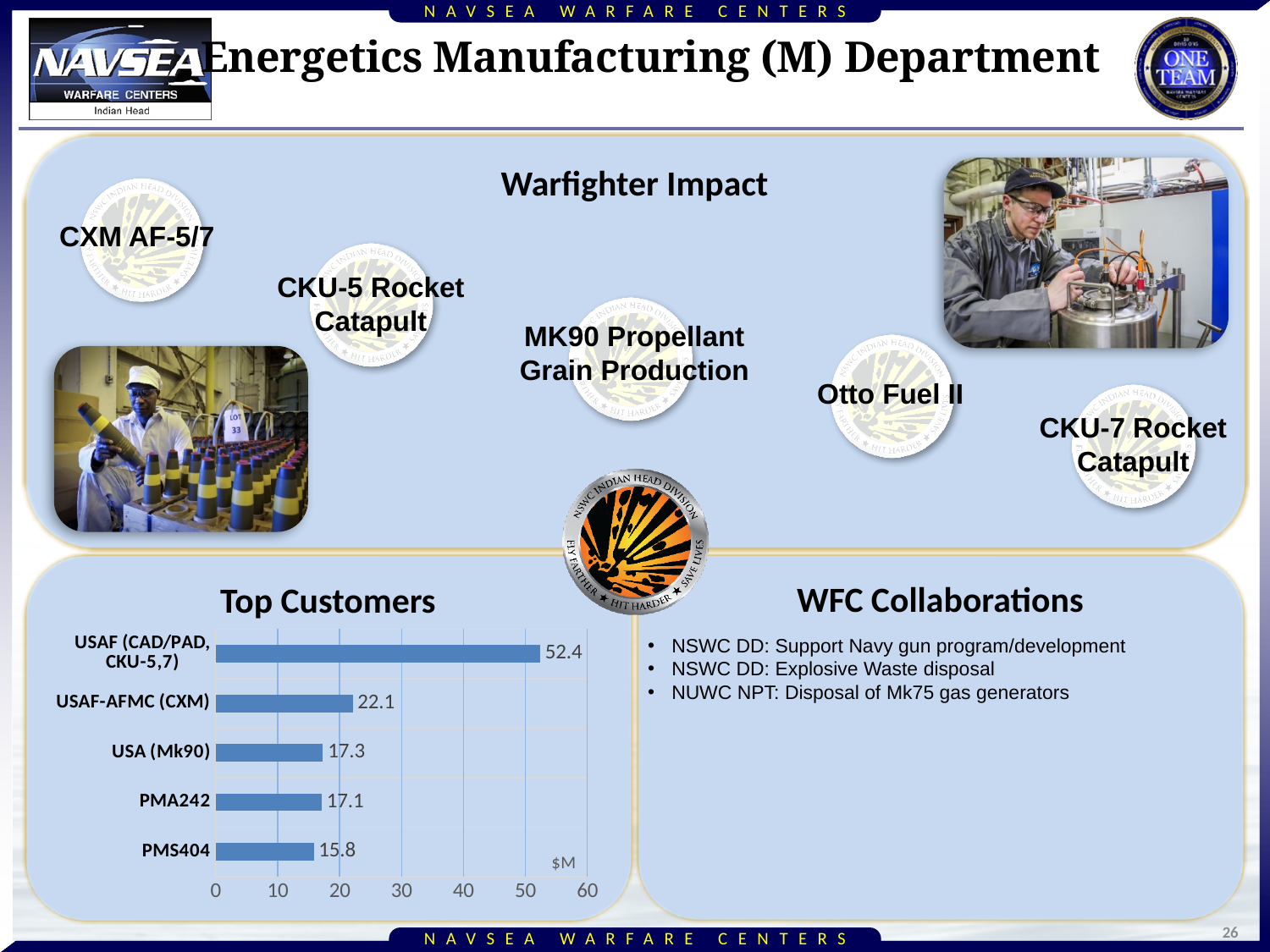
What is the value for PMS404 in the Top Customers chart? 15.8 What is the difference between the values for USA (Mk90) and PMS404 in the Top Customers chart? 1.5 Which customer has the lowest value in the Top Customers chart? PMS404 What is the value for USAF-AFMC (CXM) in the Top Customers chart? 22.1 How many customers are shown in the Top Customers chart? 5 In the Top Customers chart, which is larger: the value for USAF-AFMC (CXM) or the value for PMA242? USAF-AFMC (CXM) Which customer has the highest value in the Top Customers chart? USAF (CAD/PAD, CKU-5,7) What is the difference between the values for USAF (CAD/PAD, CKU-5,7) and USAF-AFMC (CXM) in the Top Customers chart? 30.3 Is the value for USAF (CAD/PAD, CKU-5,7) in the Top Customers chart greater or less than 50? greater What is the value for USAF (CAD/PAD, CKU-5,7) in the Top Customers chart? 52.4 What kind of chart is the Top Customers chart? bar chart What unit label is shown on the x axis of the Top Customers chart? $M